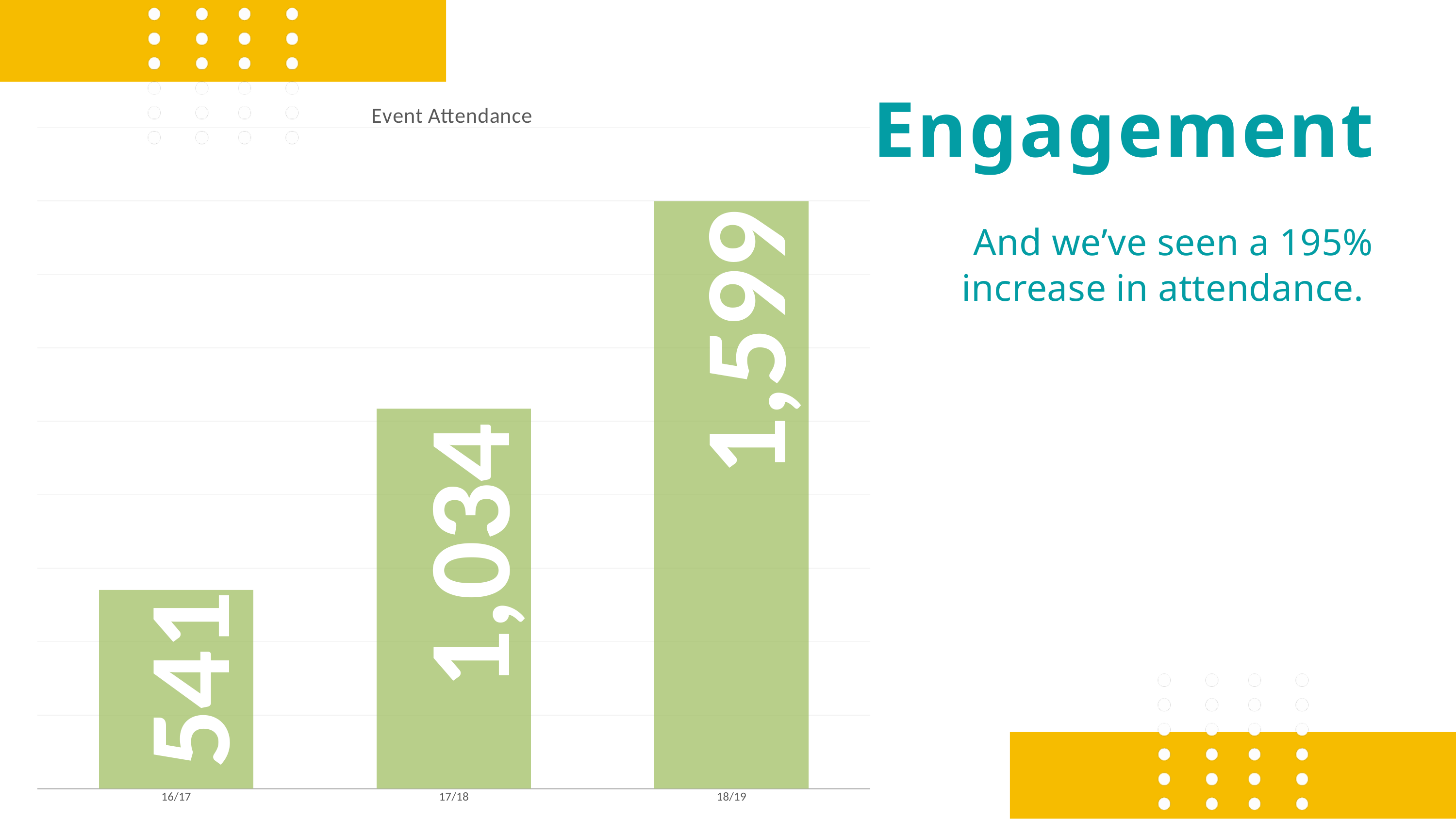
Which year has the highest event attendance? 18/19 Does event attendance rise or fall from 16/17 to 18/19? Rise How many years are shown in the Event Attendance chart? 3 What is the title of the chart? Event Attendance What is the event attendance for 16/17? 541 What is the difference in event attendance between 17/18 and 16/17? 493 What is the difference in event attendance between 18/19 and 16/17? 1,058 What kind of chart is used to show event attendance? Bar chart What is the event attendance for 17/18? 1,034 Which year has higher event attendance, 17/18 or 18/19? 18/19 Which year has the lowest event attendance? 16/17 What is the event attendance for 18/19? 1,599